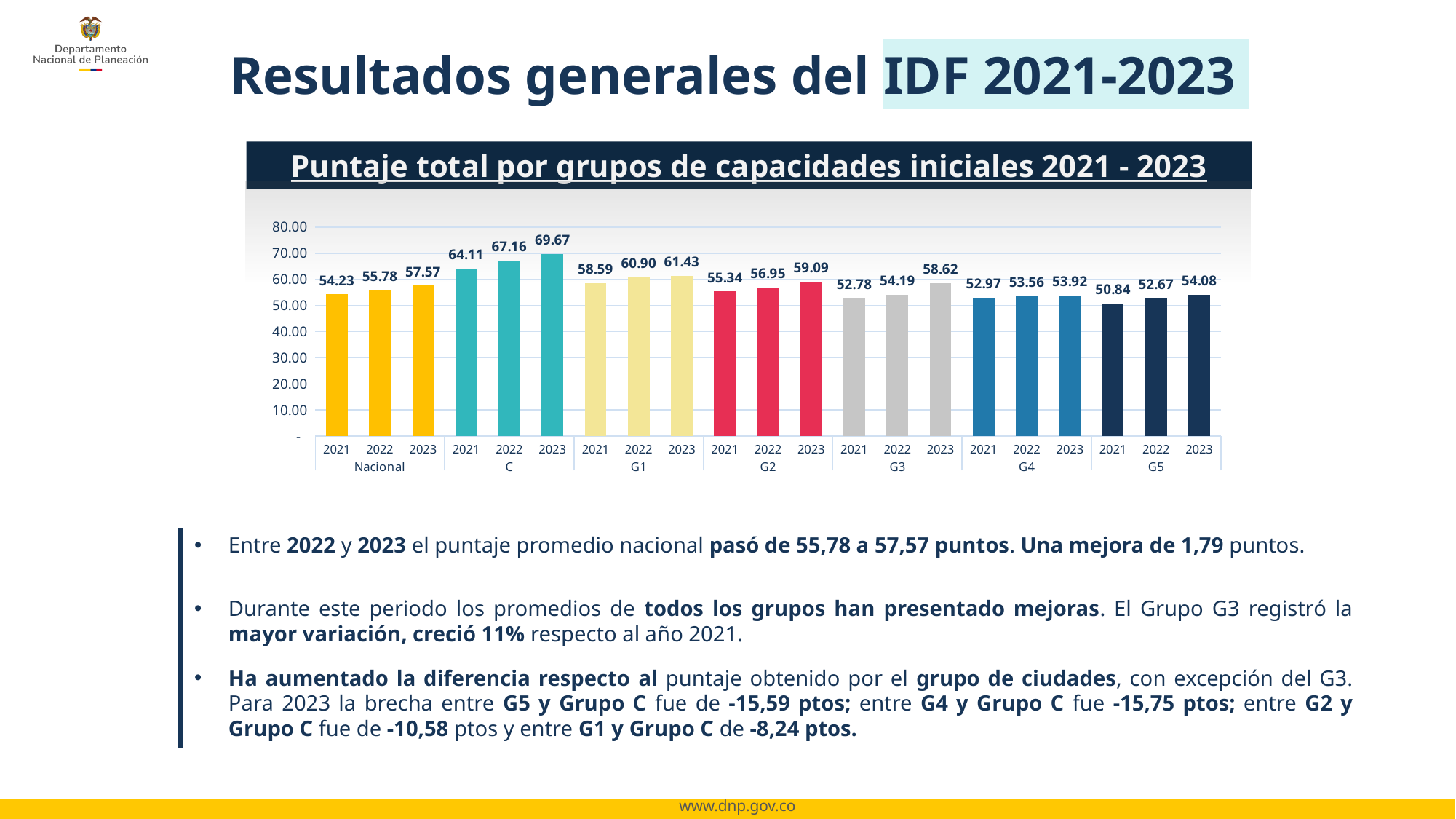
Which is larger, the 2023 value for G1 or the 2023 value for G2? G1 (61.43) Which bar has the highest value in the chart? C 2023 (69.67) Which bar has the lowest value in the chart? G5 2021 (50.84) Do the Nacional values rise or fall from 2021 to 2023? rise What is the value for G3 in 2023? 58.62 How many groups are shown on the x axis of the chart? 7 What is the difference between the 2023 value for group C and the 2023 value for G5? 15.59 What is the value for group C in 2021? 64.11 What is the value for Nacional in 2023? 57.57 What is the difference between the Nacional values for 2023 and 2022? 1.79 Is the value for G3 in 2022 greater or less than 60? less What kind of chart is shown on the slide? bar chart